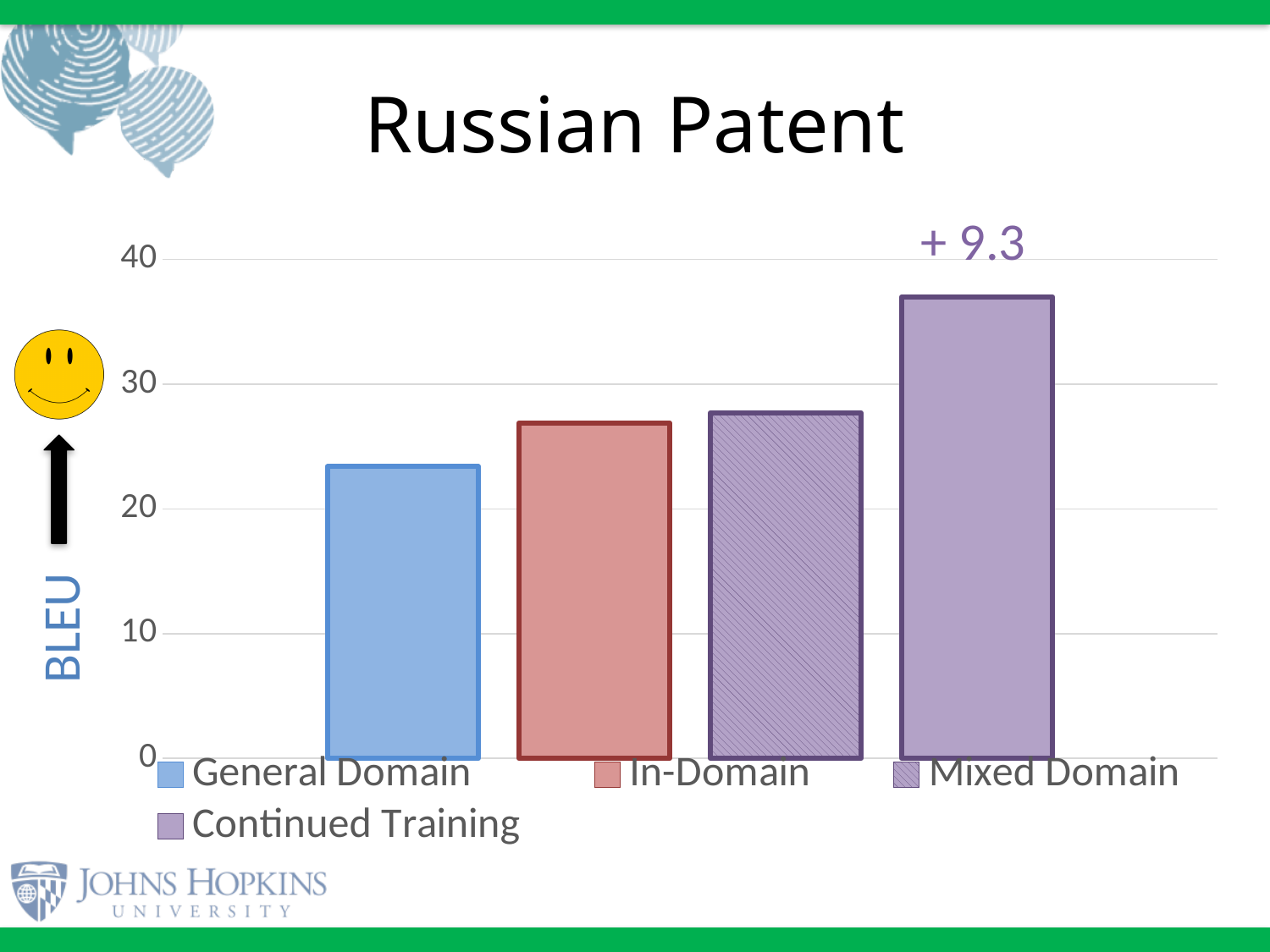
Which has a higher BLEU score, Continued Training or General Domain? Continued Training Is the BLEU value for In-Domain greater or less than 20? greater What improvement is annotated above the Continued Training bar? + 9.3 Is the BLEU value for Mixed Domain greater or less than 30? less Is the BLEU value for Continued Training greater or less than 30? greater Which series has the lowest BLEU score? General Domain Do the BLEU values rise or fall moving from left to right across the bars? rise How many series does the legend list? 4 Which series has the highest BLEU score? Continued Training What kind of chart is shown on the slide? bar chart How many bars are plotted in the chart? 4